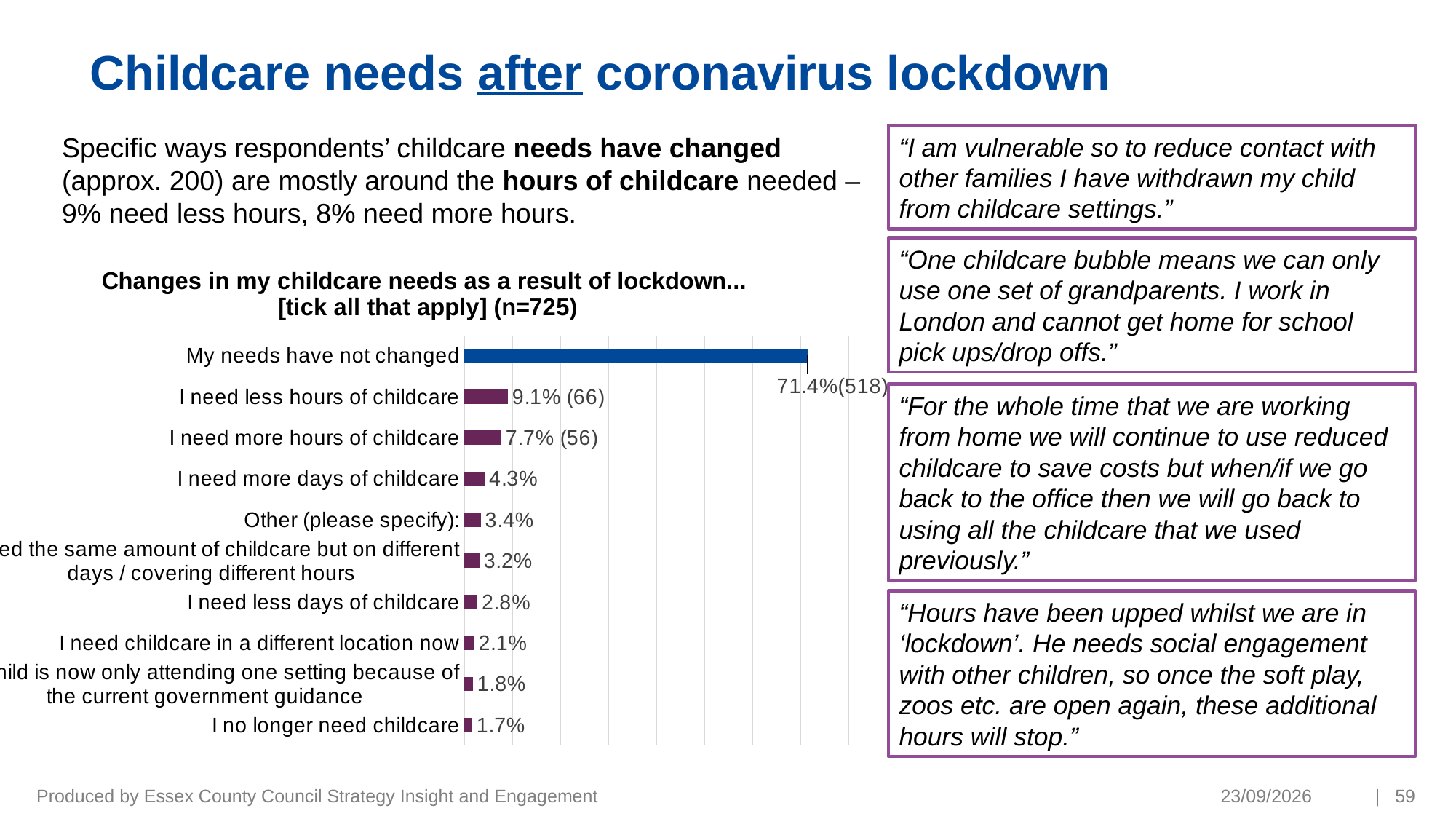
What percentage of respondents said "I no longer need childcare"? 1.7% How many respondents said "I need more hours of childcare"? 56 Which category has the lowest value in the chart? I no longer need childcare What is the difference in percentage points between "I need less hours of childcare" and "I need more hours of childcare"? 1.4 percentage points How many respondents said "My needs have not changed"? 518 What kind of chart is shown on the slide? Bar chart What is the title of the chart? Changes in my childcare needs as a result of lockdown... [tick all that apply] (n=725) Which is larger: the value for "I need less days of childcare" or "I need childcare in a different location now"? I need less days of childcare What percentage of respondents said "I need less hours of childcare"? 9.1% Which category has the highest value in the chart? My needs have not changed What percentage of respondents said "My needs have not changed"? 71.4% What percentage of respondents said "I need more days of childcare"? 4.3%